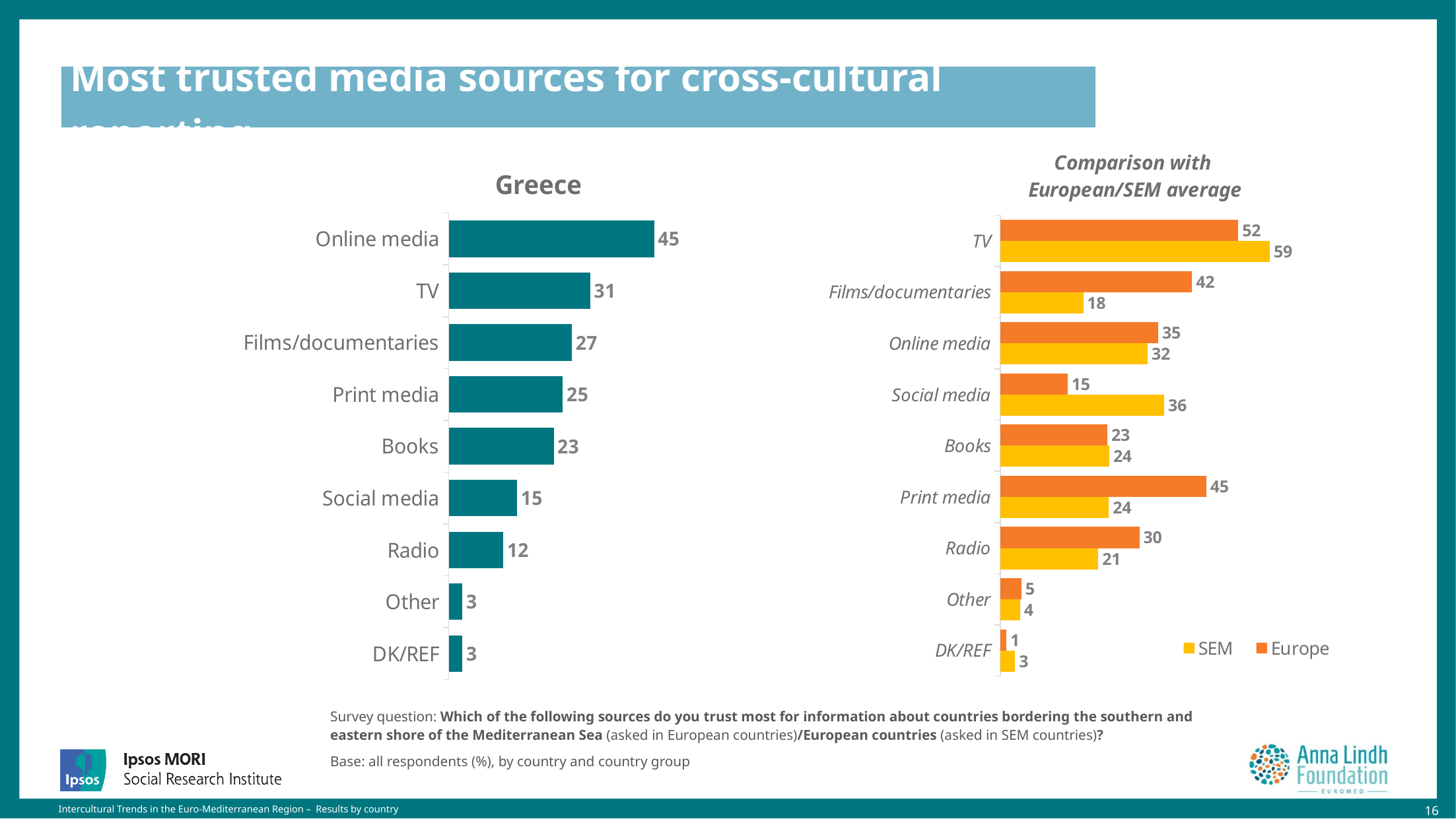
In the Comparison with European/SEM average chart, what is the difference between the Europe and SEM values for Print media? 21 In the Comparison with European/SEM average chart, which colour represents Europe? Orange What kind of chart is the Greece chart? Bar chart In the Greece chart, which category has the highest value? Online media In the Greece chart, how many categories are shown? 9 In the Comparison with European/SEM average chart, what is the SEM value for TV? 59 In the Comparison with European/SEM average chart, how many series does the legend list? 2 In the Greece chart, what is the value for Print media? 25 In the Comparison with European/SEM average chart, which is larger for Social media, the SEM value or the Europe value? SEM In the Comparison with European/SEM average chart, what is the Europe value for Films/documentaries? 42 In the Greece chart, what is the value for Online media? 45 In the Greece chart, what is the difference between the values for TV and Radio? 19